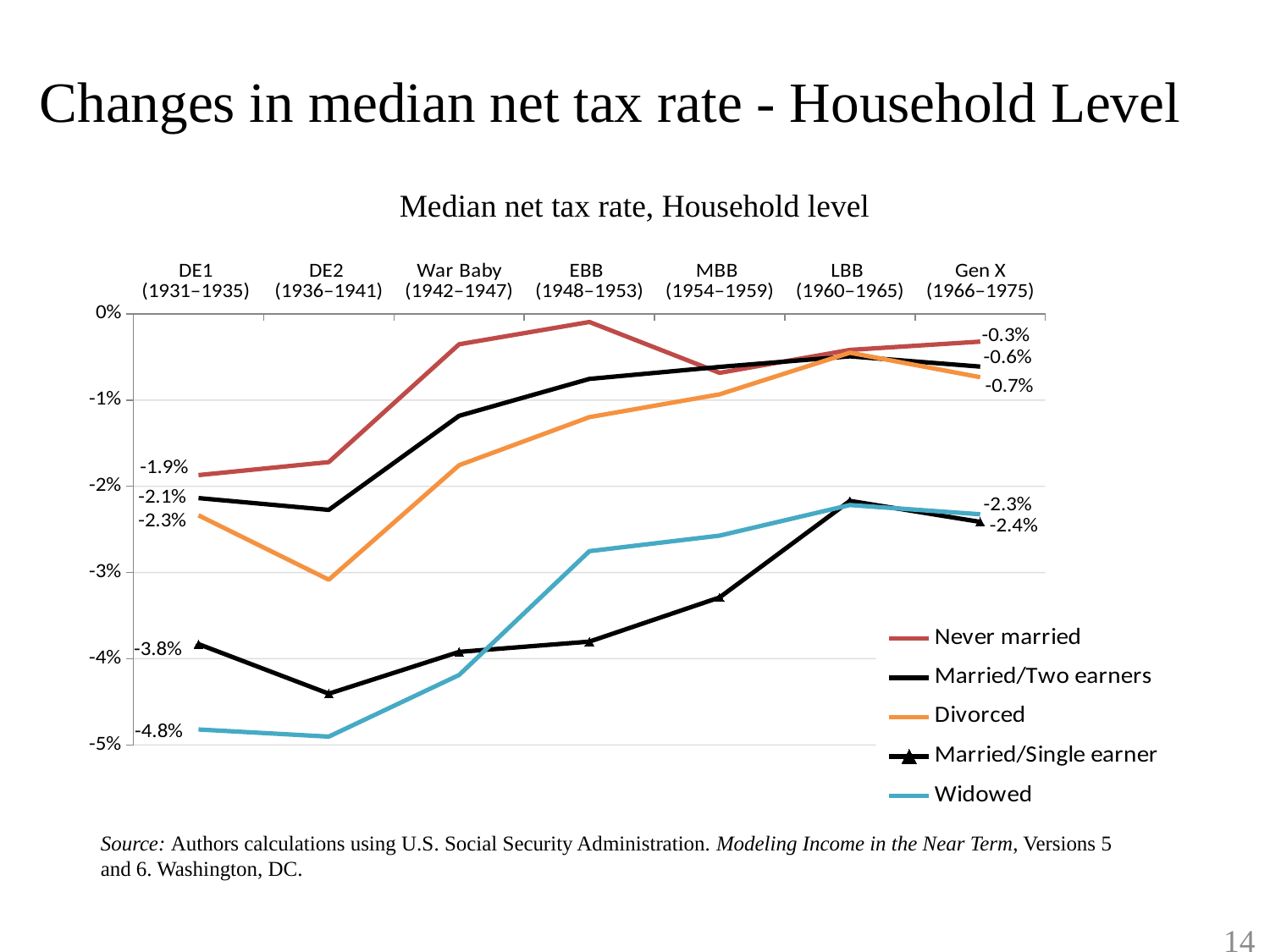
Does the Married/Single earner line generally rise or fall from DE2 (1936–1941) to LBB (1960–1965)? rise Is the Widowed value for the DE2 (1936–1941) cohort greater or less than -4%? less How many series does the legend list? 5 What is the difference between the Never married and Widowed values in the DE1 (1931–1935) cohort? 2.9 percentage points Which series has the lowest median net tax rate in the DE1 (1931–1935) cohort? Widowed What type of chart is shown on the slide? line chart What is the median net tax rate for Never married households in the Gen X (1966–1975) cohort? -0.3% What is the median net tax rate for Widowed households in the DE1 (1931–1935) cohort? -4.8% What is the median net tax rate for Divorced households in the Gen X (1966–1975) cohort? -0.7% Which series has the highest median net tax rate in the Gen X (1966–1975) cohort? Never married What is the median net tax rate for Married/Single earner households in the DE1 (1931–1935) cohort? -3.8% How many cohort categories are shown along the x axis? 7